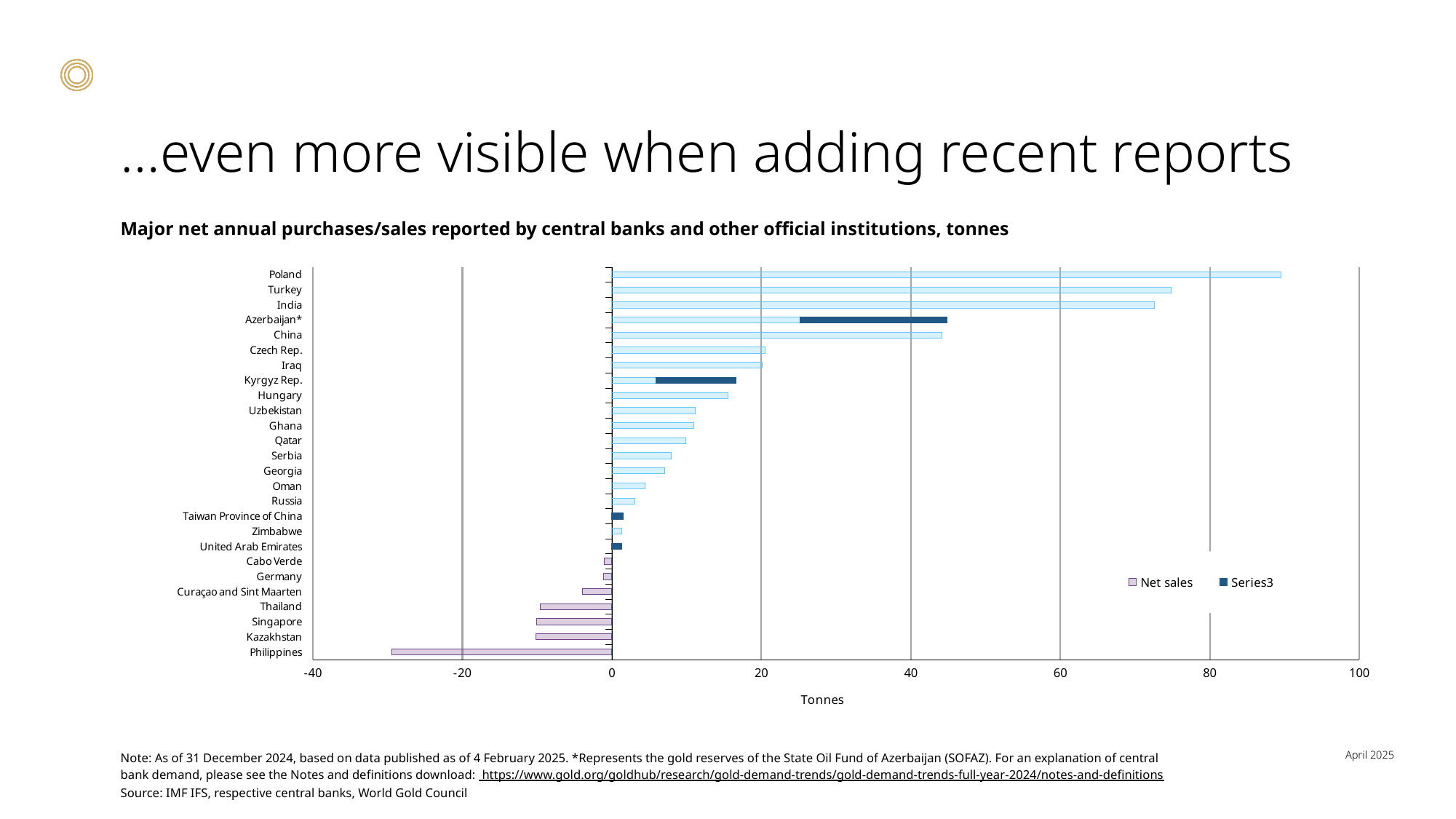
What kind of chart is shown on the slide? Bar chart How many entries does the chart's legend list? 2 Which country has the lowest value in the chart? Philippines How many countries or institutions are listed on the vertical axis of the chart? 26 Is the value for the Philippines greater or less than -20? less Which country has the highest value in the chart? Poland Is the value for Poland greater or less than 80? greater Is the value for Turkey greater or less than 80? less Which has the larger value, China or Czech Rep.? China What is the label on the horizontal axis of the chart? Tonnes Which has the larger value, Poland or Turkey? Poland